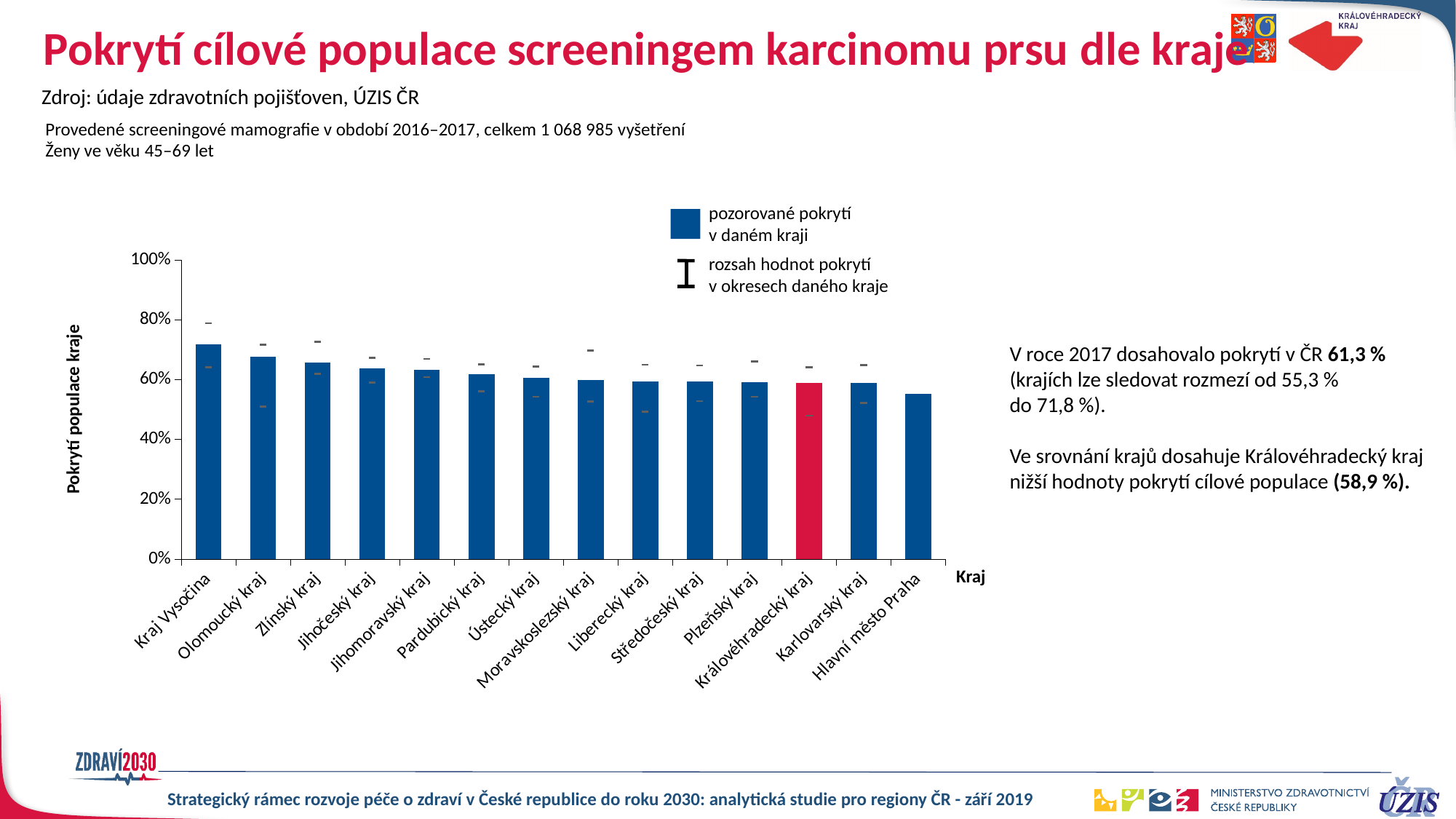
What is the coverage value for Královéhradecký kraj stated on the slide? 58,9 % Which region has the lowest coverage in the chart? Hlavní město Praha Is the value for Kraj Vysočina greater or less than 60%? greater What kind of chart is shown on the slide? bar chart Which is larger, the value for Kraj Vysočina or the value for Hlavní město Praha? Kraj Vysočina How many regions (kraje) are shown on the x axis of the chart? 14 Which region has the highest coverage in the chart? Kraj Vysočina Which region's bar is highlighted in red in the chart? Královéhradecký kraj How many entries does the chart legend list? 2 Is the value for Hlavní město Praha greater or less than 60%? less Do the bar values rise or fall from left to right along the x axis? fall Is the value for Olomoucký kraj greater or less than 60%? greater